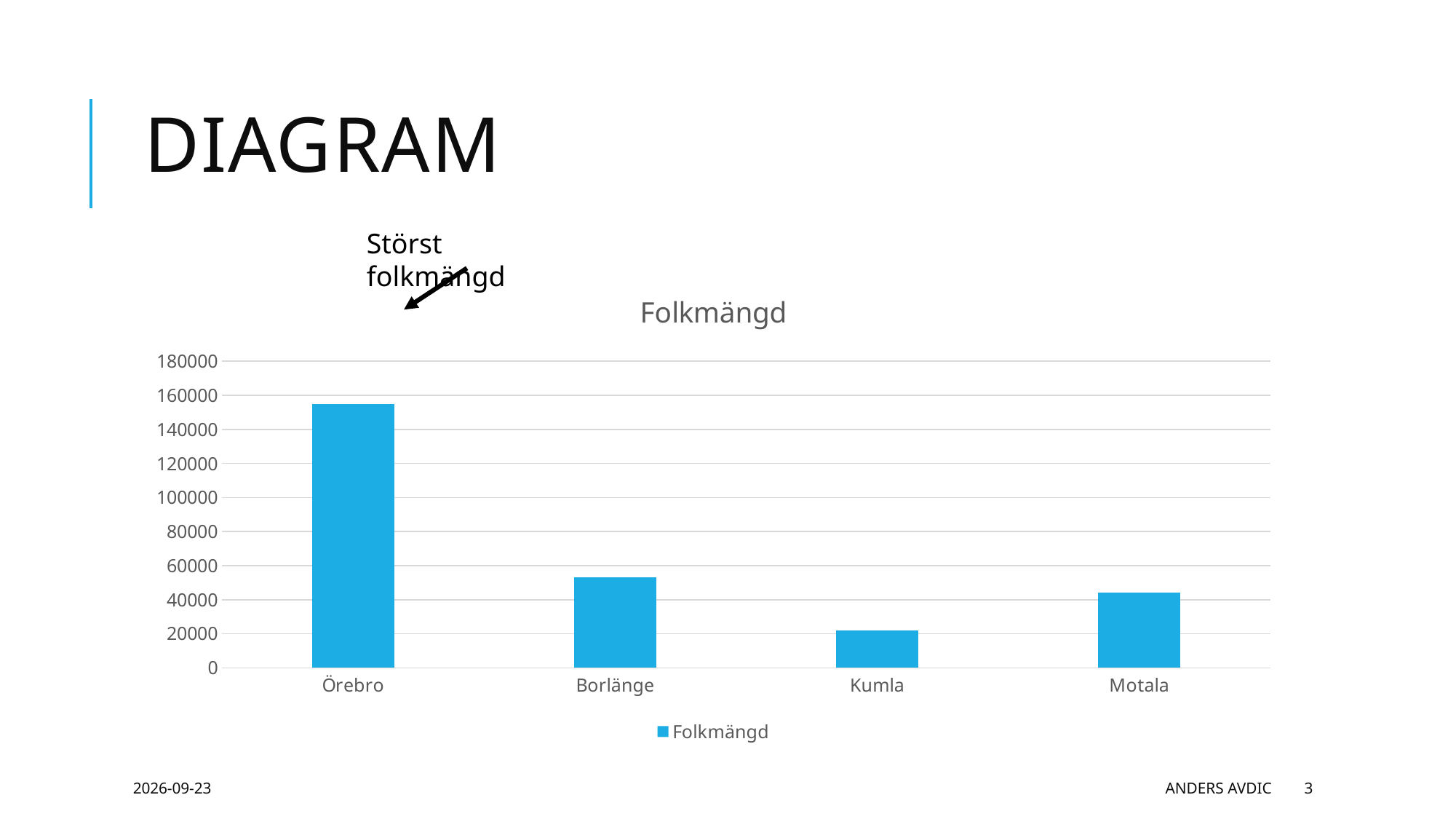
What is the name of the series shown in the chart legend? Folkmängd Is the value for Örebro greater or less than 140000? greater Which is larger, the value for Borlänge or the value for Motala? Borlänge Is the value for Kumla greater or less than 40000? less Is the value for Motala greater or less than 40000? greater How many series does the chart legend list? 1 Which category has the highest value in the chart? Örebro Which category has the lowest value in the chart? Kumla What kind of chart is shown on the slide? bar chart What is the title of the chart? Folkmängd How many categories are shown on the x axis of the chart? 4